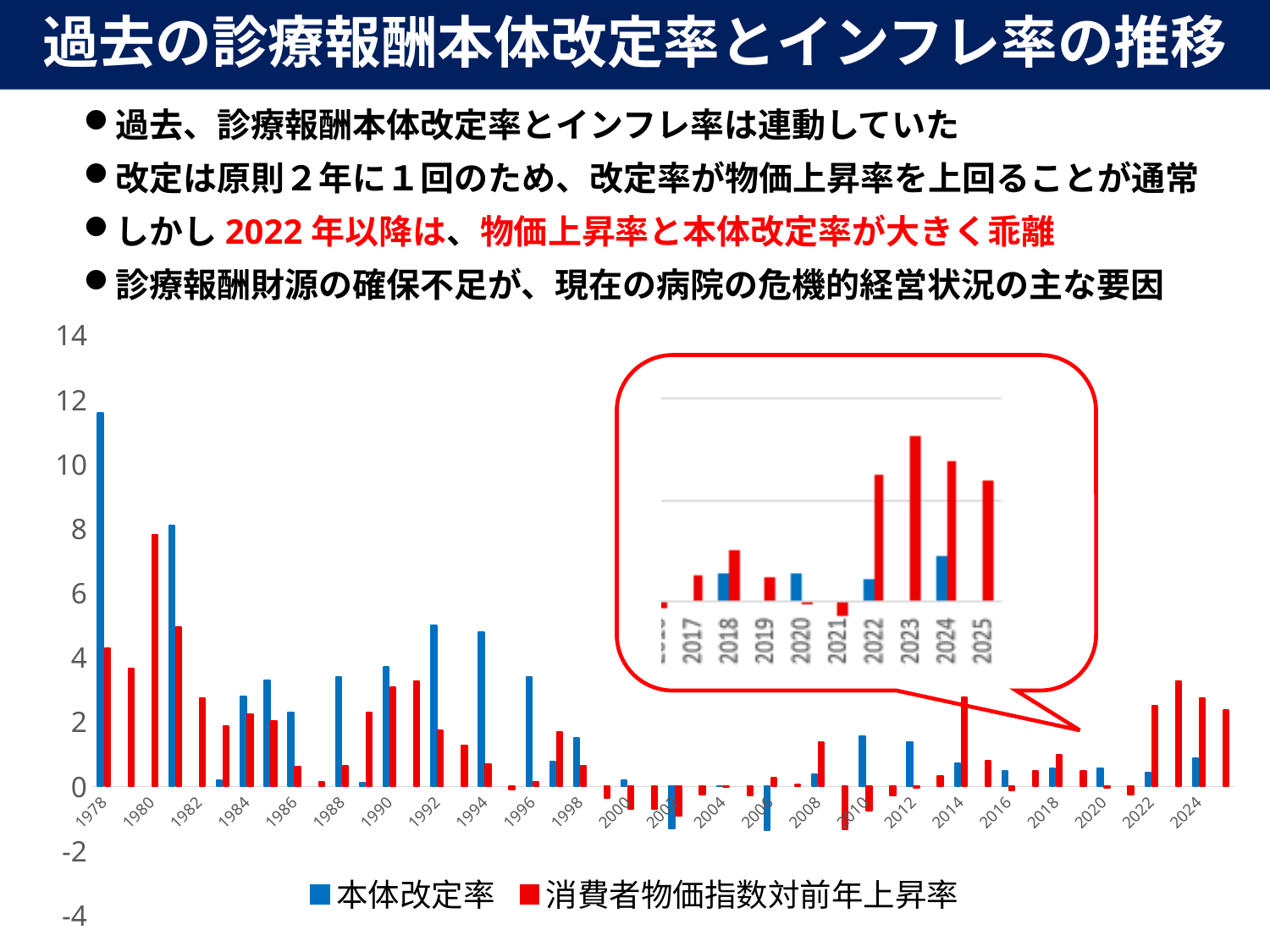
In 2023, which is larger: 本体改定率 or 消費者物価指数対前年上昇率? 消費者物価指数対前年上昇率 Is the 消費者物価指数対前年上昇率 value for 1980 greater or less than 6? greater Is the 本体改定率 value for 1981 greater or less than 6? greater In which year is the 本体改定率 bar the highest? 1978 What are the two series named in the chart's legend? 本体改定率 and 消費者物価指数対前年上昇率 Does the 本体改定率 series generally rise or fall from 1978 to 2000? fall How many series does the chart's legend list? 2 Which years does the zoomed-in inset chart cover? 2017 to 2025 In 1978, which is larger: 本体改定率 or 消費者物価指数対前年上昇率? 本体改定率 Is the 本体改定率 value for 1978 greater or less than 10? greater In 1992, which is larger: 本体改定率 or 消費者物価指数対前年上昇率? 本体改定率 What kind of chart is shown on the slide? bar chart